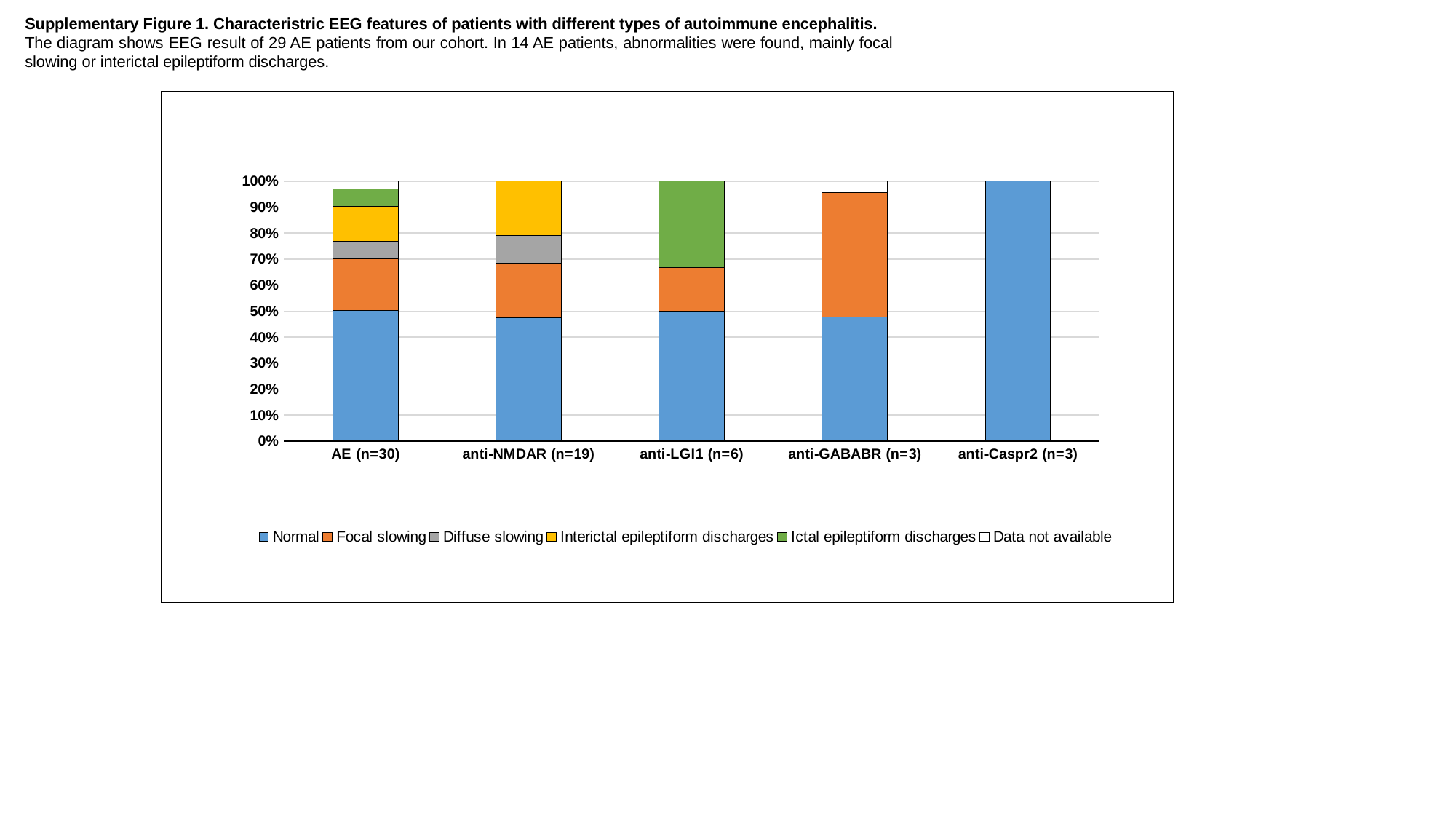
Is the Focal slowing segment larger for anti-GABABR (n=3) or for AE (n=30)? anti-GABABR (n=3) What is the Normal share for AE (n=30)? 50% Which patient group has the largest Normal share? anti-Caspr2 (n=3) What is the Normal share for anti-Caspr2 (n=3)? 100% What is the Normal share for anti-LGI1 (n=6)? 50% Is the Normal share for anti-NMDAR (n=19) greater or less than 60%? less Which patient group has the largest Ictal epileptiform discharges segment? anti-LGI1 (n=6) Which colour represents the Normal series in the legend? Blue What kind of chart is shown on the slide? Stacked bar chart How many patient groups (categories) are shown on the x axis? 5 What is the total of the stacked bar for anti-NMDAR (n=19)? 100% How many series does the legend list? 6